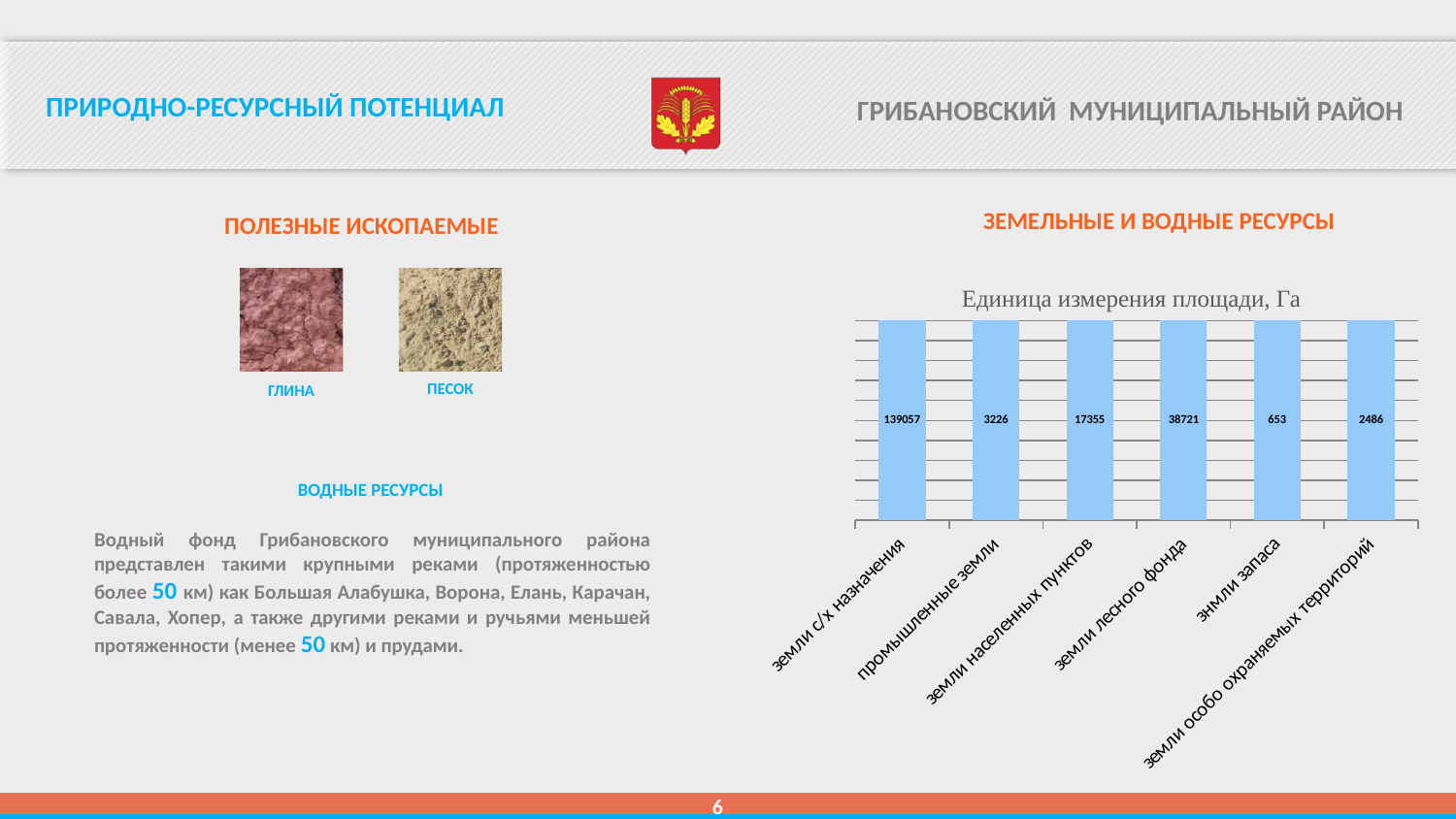
Which category has the highest value according to the data labels? земли с/х назначения What is the value for земли лесного фонда? 38721 What is the value for земли особо охраняемых территорий? 2486 What is the value for промышленные земли? 3226 Which is larger, the value for промышленные земли or the value for земли особо охраняемых территорий? промышленные земли What is the value for земли запаса? 653 What is the difference between the values for земли лесного фонда and земли населенных пунктов? 21366 Which category has the lowest value according to the data labels? земли запаса What is the value for земли с/х назначения? 139057 How many categories are shown in the chart? 6 What is the value for земли населенных пунктов? 17355 What is the title of the chart? Единица измерения площади, Га